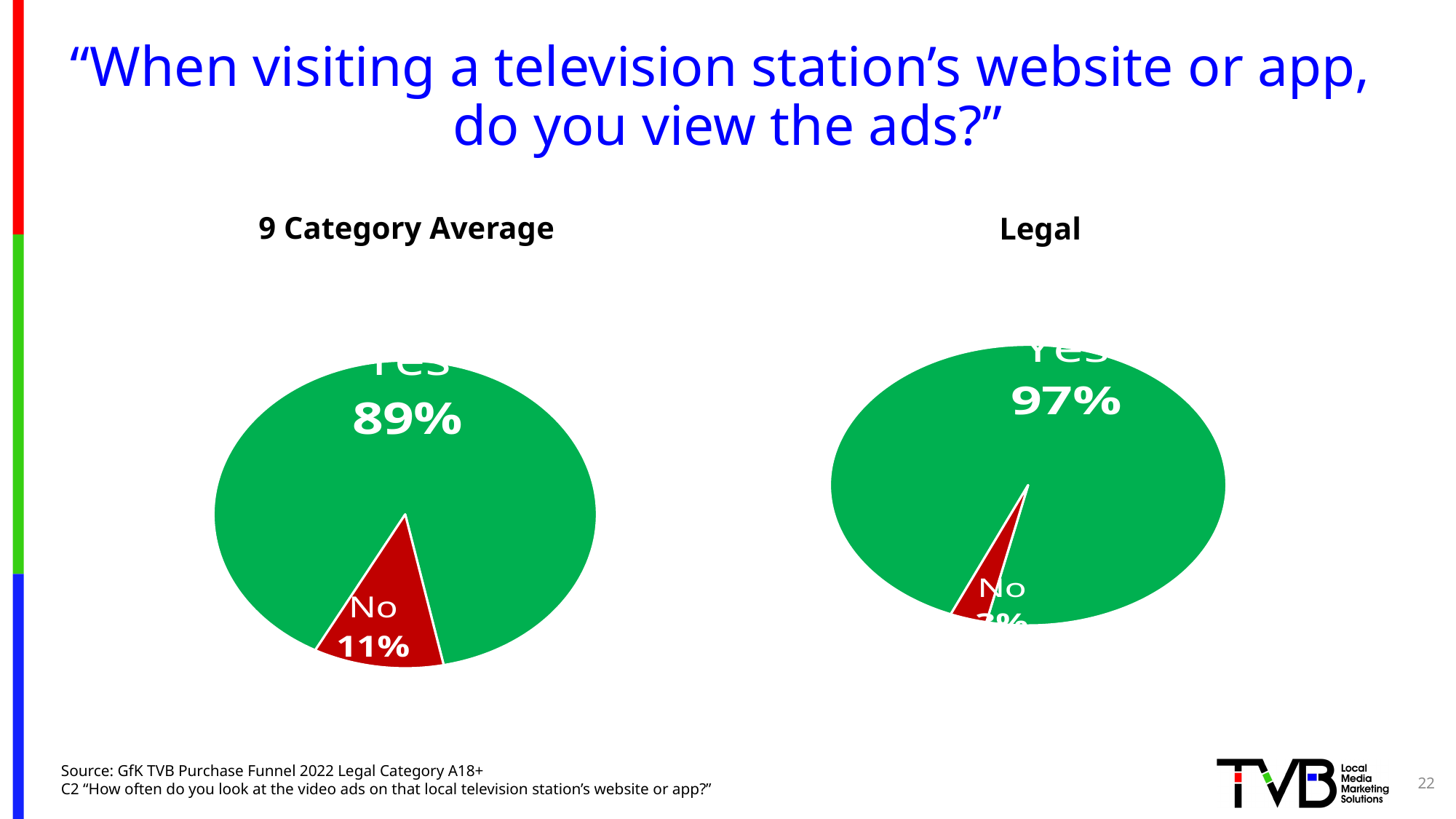
In the Legal chart, which response has the smaller share? No In the Legal chart, what percentage answered Yes? 97% What type of chart is used on this slide? Pie chart In the 9 Category Average chart, what percentage answered No? 11% What colour is the Yes slice in the Legal chart? Green Which chart shows a higher Yes share, 9 Category Average or Legal? Legal In the 9 Category Average chart, which response has the larger share? Yes Which chart shows a larger No slice, 9 Category Average or Legal? 9 Category Average How many slices does the 9 Category Average pie chart have? 2 What is the difference between the Yes share in the Legal chart and the Yes share in the 9 Category Average chart? 8 percentage points In the 9 Category Average chart, what is the difference between the Yes and No shares? 78 percentage points In the 9 Category Average chart, what percentage answered Yes? 89%